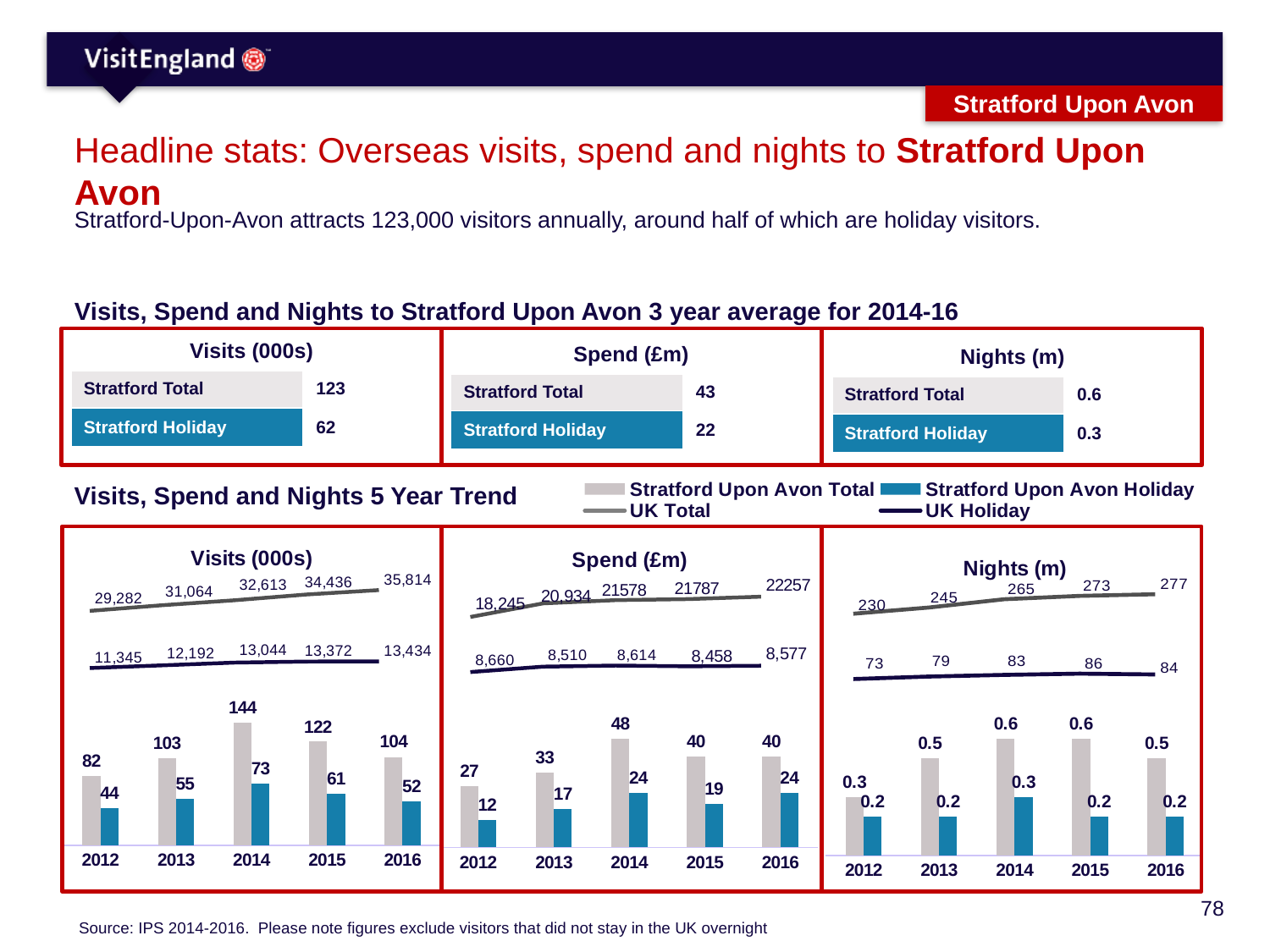
In the Visits (000s) chart, which year has the highest Stratford Upon Avon Total value? 2014 How many years are shown on the x axis of the Nights (m) chart? 5 What kind of chart is used for the Stratford Upon Avon Total and Holiday series in the Visits (000s) chart? Bar chart In the Visits (000s) chart, what is the Stratford Upon Avon Total value for 2014? 144 In the Visits (000s) chart, does the UK Total line rise or fall from 2012 to 2016? Rise In the Spend (£m) chart, which year has the lowest Stratford Upon Avon Holiday value? 2012 In the Nights (m) chart, what is the UK Holiday value for 2015? 86 How many series does the legend for the 5 Year Trend charts list? 4 In the Visits (000s) chart, what is the difference between the Stratford Upon Avon Total and Stratford Upon Avon Holiday values for 2015? 61 In the Spend (£m) chart, which is larger: the Stratford Upon Avon Total value for 2013 or for 2015? 2015 In the Nights (m) chart, what is the UK Total value for 2016? 277 In the Spend (£m) chart, what is the Stratford Upon Avon Holiday value for 2013? 17